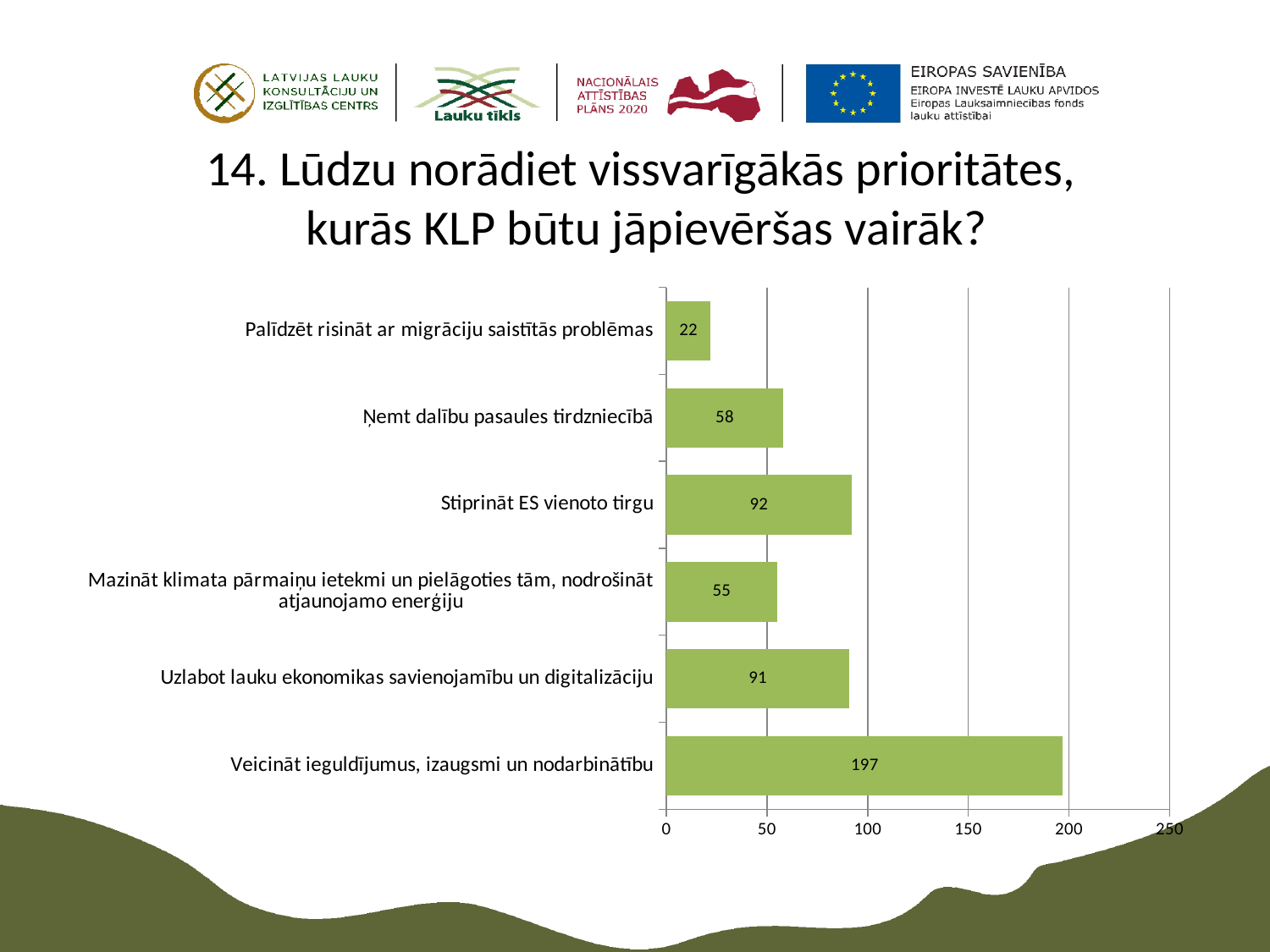
What value is shown for "Ņemt dalību pasaules tirdzniecībā"? 58 Which has a larger value: "Ņemt dalību pasaules tirdzniecībā" or "Mazināt klimata pārmaiņu ietekmi un pielāgoties tām, nodrošināt atjaunojamo enerģiju"? Ņemt dalību pasaules tirdzniecībā What is the difference between the values for "Veicināt ieguldījumus, izaugsmi un nodarbinātību" and "Stiprināt ES vienoto tirgu"? 105 What kind of chart is shown on the slide? bar chart What is the maximum value shown on the horizontal axis? 250 What value is shown for "Veicināt ieguldījumus, izaugsmi un nodarbinātību"? 197 Which category has the lowest value? Palīdzēt risināt ar migrāciju saistītās problēmas Which category has the highest value? Veicināt ieguldījumus, izaugsmi un nodarbinātību What value is shown for "Stiprināt ES vienoto tirgu"? 92 Is the value for "Uzlabot lauku ekonomikas savienojamību un digitalizāciju" greater or less than 100? less What is the difference between the values for "Ņemt dalību pasaules tirdzniecībā" and "Palīdzēt risināt ar migrāciju saistītās problēmas"? 36 How many categories are shown in the chart? 6